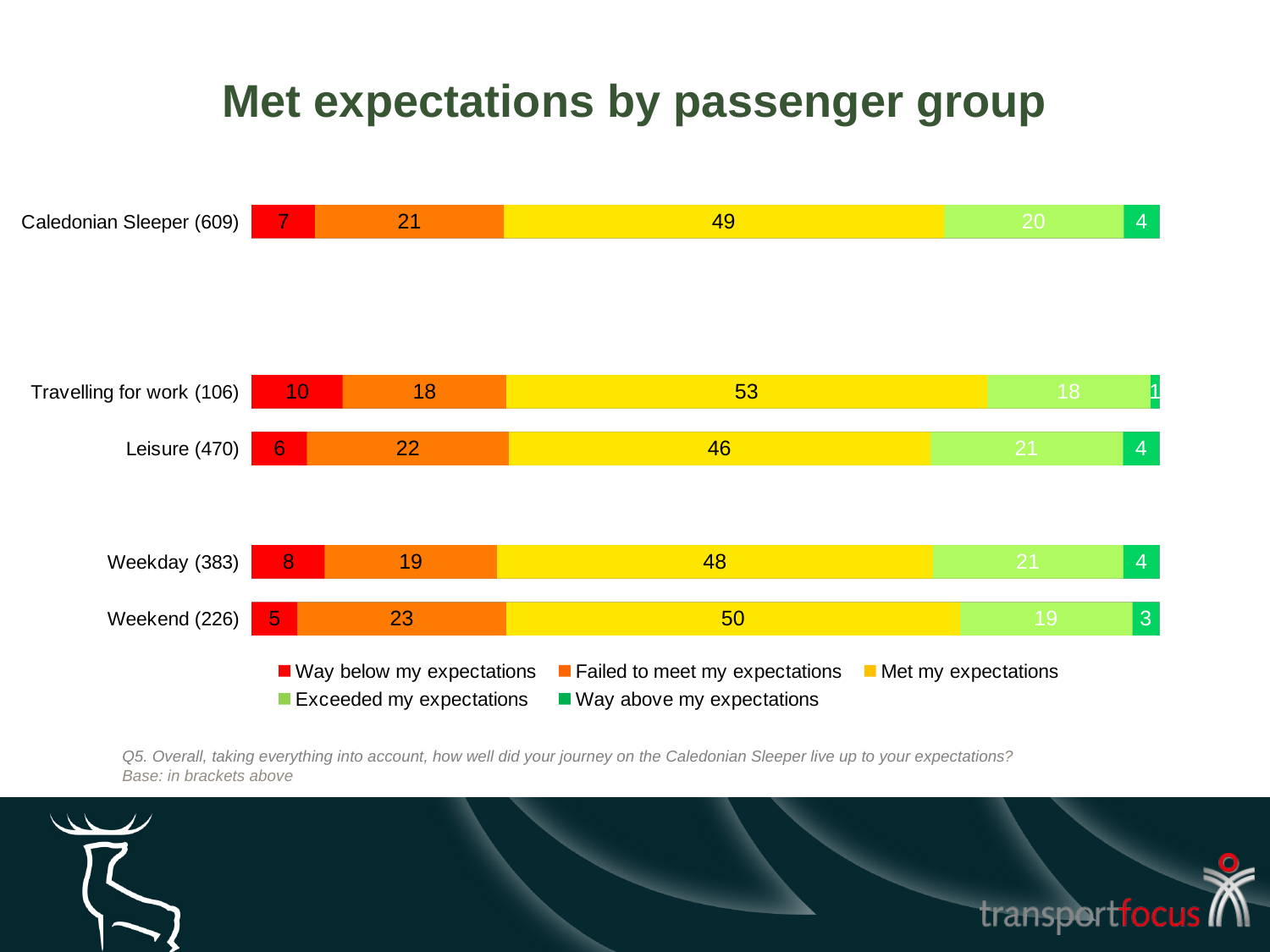
How many passenger groups are plotted on the chart? 5 Which is larger: the 'Way below my expectations' value for Travelling for work (106) or for Leisure (470)? Travelling for work (106) What is the total of the stacked bar for Weekday (383)? 100 Which passenger group has the lowest value for 'Way above my expectations'? Travelling for work (106) What is the value for 'Way below my expectations' for Weekend (226)? 5 Which passenger group has the highest value for 'Met my expectations'? Travelling for work (106) What is the title of the chart? Met expectations by passenger group How many series does the legend list? 5 What is the difference between the 'Failed to meet my expectations' values for Weekend (226) and Weekday (383)? 4 What is the value for 'Met my expectations' for Travelling for work (106)? 53 What is the value for 'Exceeded my expectations' for Leisure (470)? 21 What kind of chart is shown on the slide? Stacked bar chart